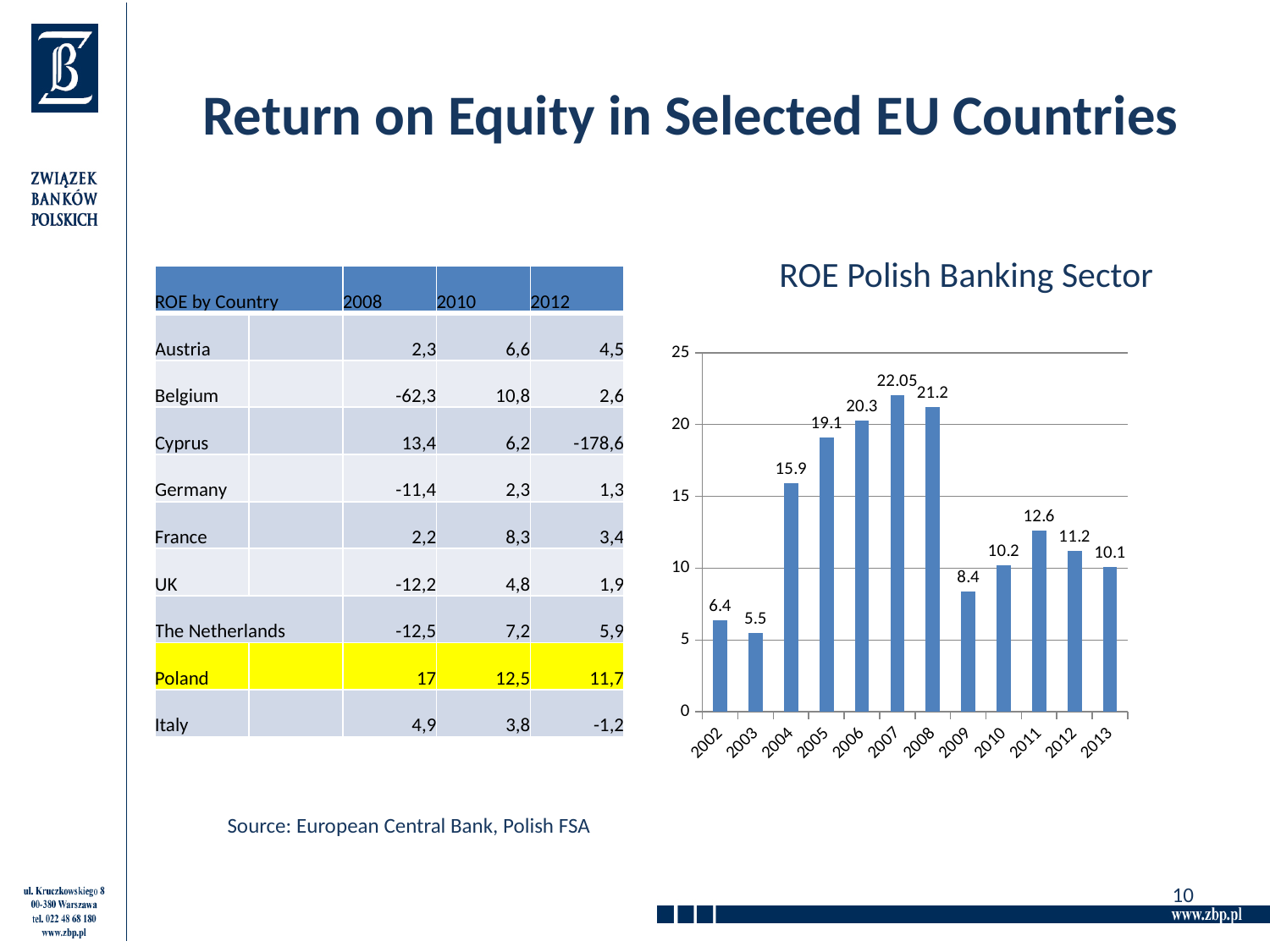
What is the ROE value for 2007 in the ROE Polish Banking Sector chart? 22.05 What is the ROE value for 2009 in the ROE Polish Banking Sector chart? 8.4 What is the ROE value for 2013 in the ROE Polish Banking Sector chart? 10.1 What is the difference between the ROE values for 2007 and 2008 in the ROE Polish Banking Sector chart? 0.85 What is the difference between the ROE values for 2004 and 2002 in the ROE Polish Banking Sector chart? 9.5 How many years are shown in the ROE Polish Banking Sector chart? 12 Which year has the highest ROE in the ROE Polish Banking Sector chart? 2007 Which year has the lowest ROE in the ROE Polish Banking Sector chart? 2003 Do the ROE values rise or fall from 2008 to 2009 in the ROE Polish Banking Sector chart? fall Is the ROE value for 2005 greater or less than 15 in the ROE Polish Banking Sector chart? greater Which year has a higher ROE in the ROE Polish Banking Sector chart, 2011 or 2012? 2011 What kind of chart is the ROE Polish Banking Sector chart? bar chart